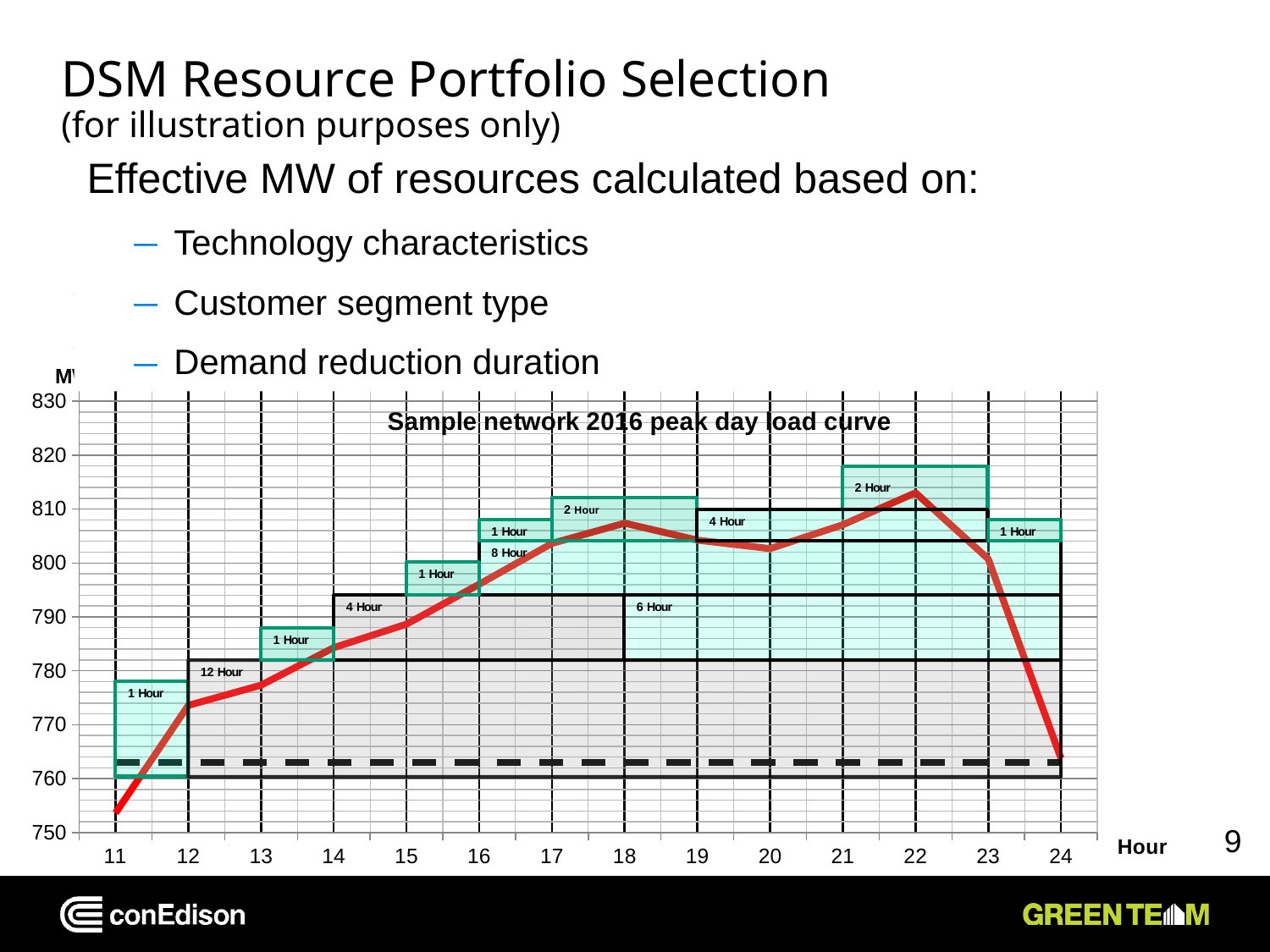
Is the value of the load curve at hour 14 greater or less than 780? greater Is the value of the load curve at hour 24 greater or less than 770? less Is the value of the load curve at hour 11 greater or less than 760? less What kind of chart is shown on the slide? line chart At which hour does the red load curve have its lowest value? 11 Does the load curve generally rise or fall between hour 11 and hour 22? rise What is the title printed inside the chart? Sample network 2016 peak day load curve Which hour has the higher load value, hour 23 or hour 24? 23 How many hours are marked along the x axis of the chart? 14 Which hour has the higher load value, hour 12 or hour 15? 15 At which hour does the red load curve reach its highest value? 22